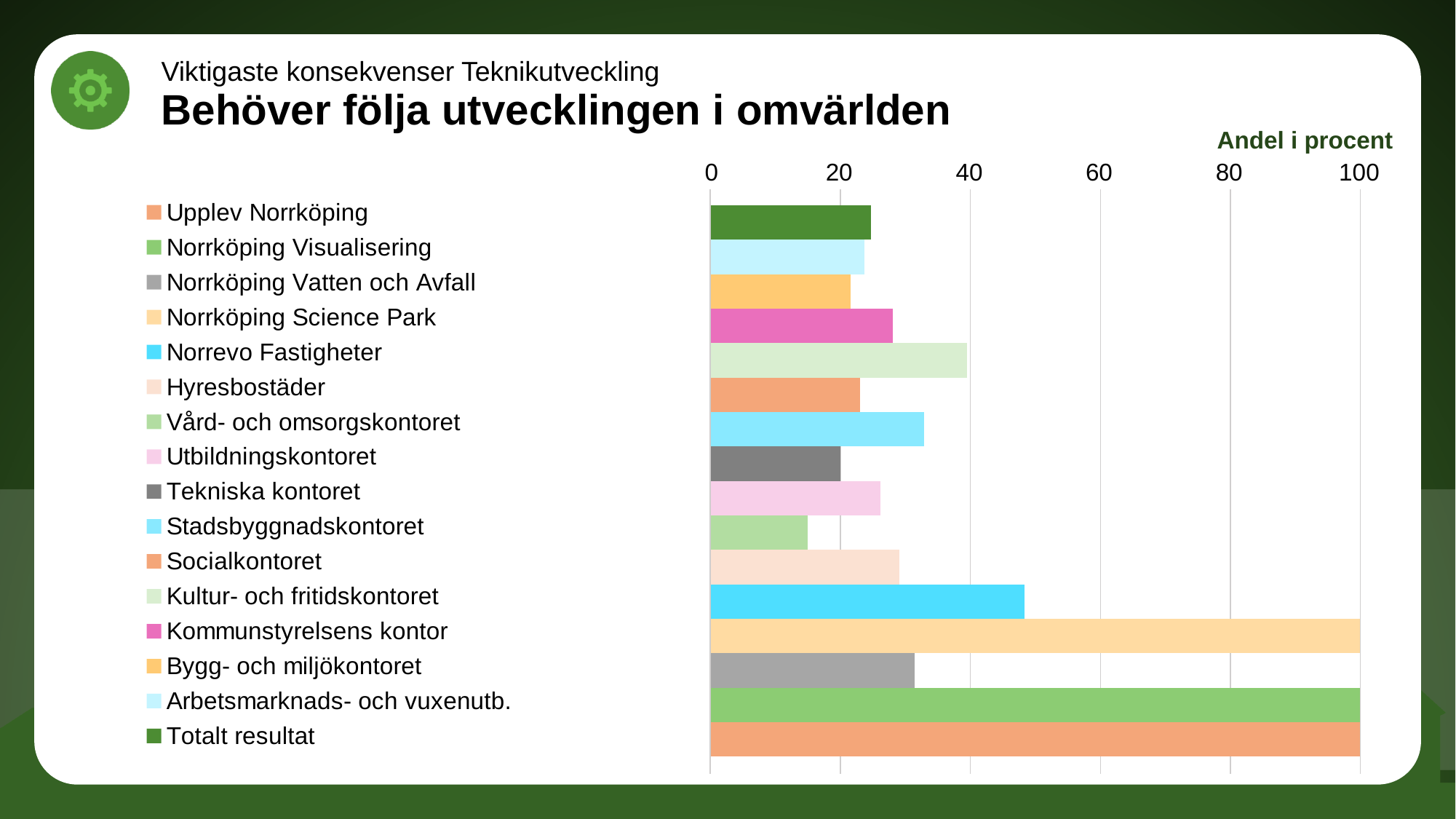
Is the value for Hyresbostäder greater or less than 20? greater Is the value for Norrevo Fastigheter greater or less than 40? greater What is the value for Norrköping Science Park? 100 What is the value for Upplev Norrköping? 100 Is the value for Vård- och omsorgskontoret greater or less than 20? less Which category has the lowest value? Vård- och omsorgskontoret Which is larger, the value for Norrevo Fastigheter or the value for Stadsbyggnadskontoret? Norrevo Fastigheter Which is larger, the value for Kultur- och fritidskontoret or the value for Socialkontoret? Kultur- och fritidskontoret What label is shown above the horizontal axis of the chart? Andel i procent What kind of chart is shown on the slide? bar chart How many categories does the chart's legend list? 16